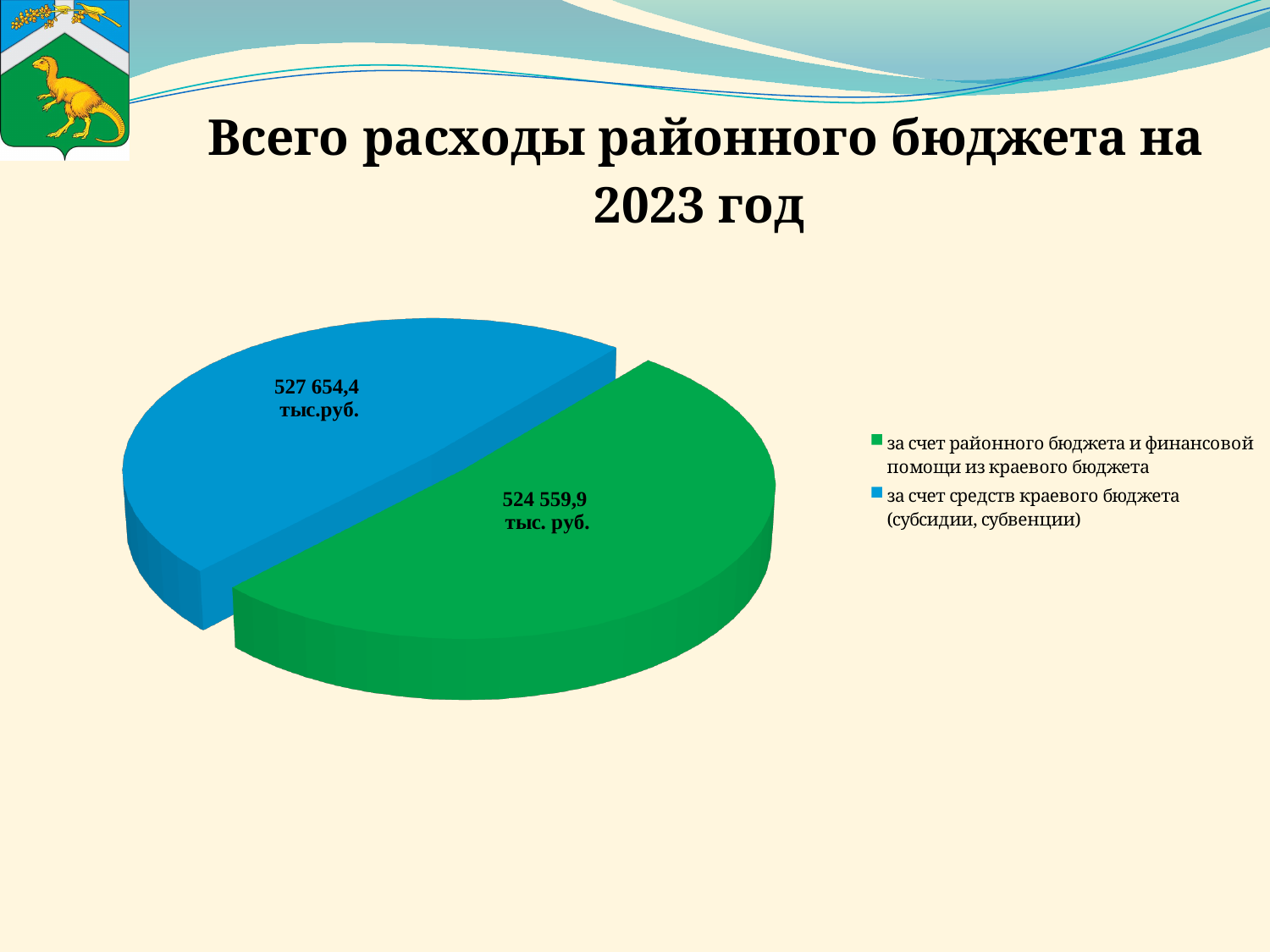
What is the title of the chart on the slide? Всего расходы районного бюджета на 2023 год Which slice has the larger value according to the data labels? за счет средств краевого бюджета (субсидии, субвенции) What kind of chart is shown on the slide? Pie chart What is the difference between the two slice values, 527 654,4 and 524 559,9 тыс. руб.? 3 094,5 тыс. руб. Based on the printed labels, is the value for 'за счет средств краевого бюджета (субсидии, субвенции)' larger or smaller than the value for 'за счет районного бюджета и финансовой помощи из краевого бюджета'? larger How many entries does the legend list? 2 Which slice has the smaller value according to the data labels? за счет районного бюджета и финансовой помощи из краевого бюджета What value is shown for the slice 'за счет средств краевого бюджета (субсидии, субвенции)'? 527 654,4 тыс.руб. How many slices does the pie chart have? 2 What is the total of the two slice values shown on the pie chart? 1 052 214,3 тыс. руб. What value is shown for the slice 'за счет районного бюджета и финансовой помощи из краевого бюджета'? 524 559,9 тыс. руб. What colour is the slice for 'за счет средств краевого бюджета (субсидии, субвенции)'? Blue